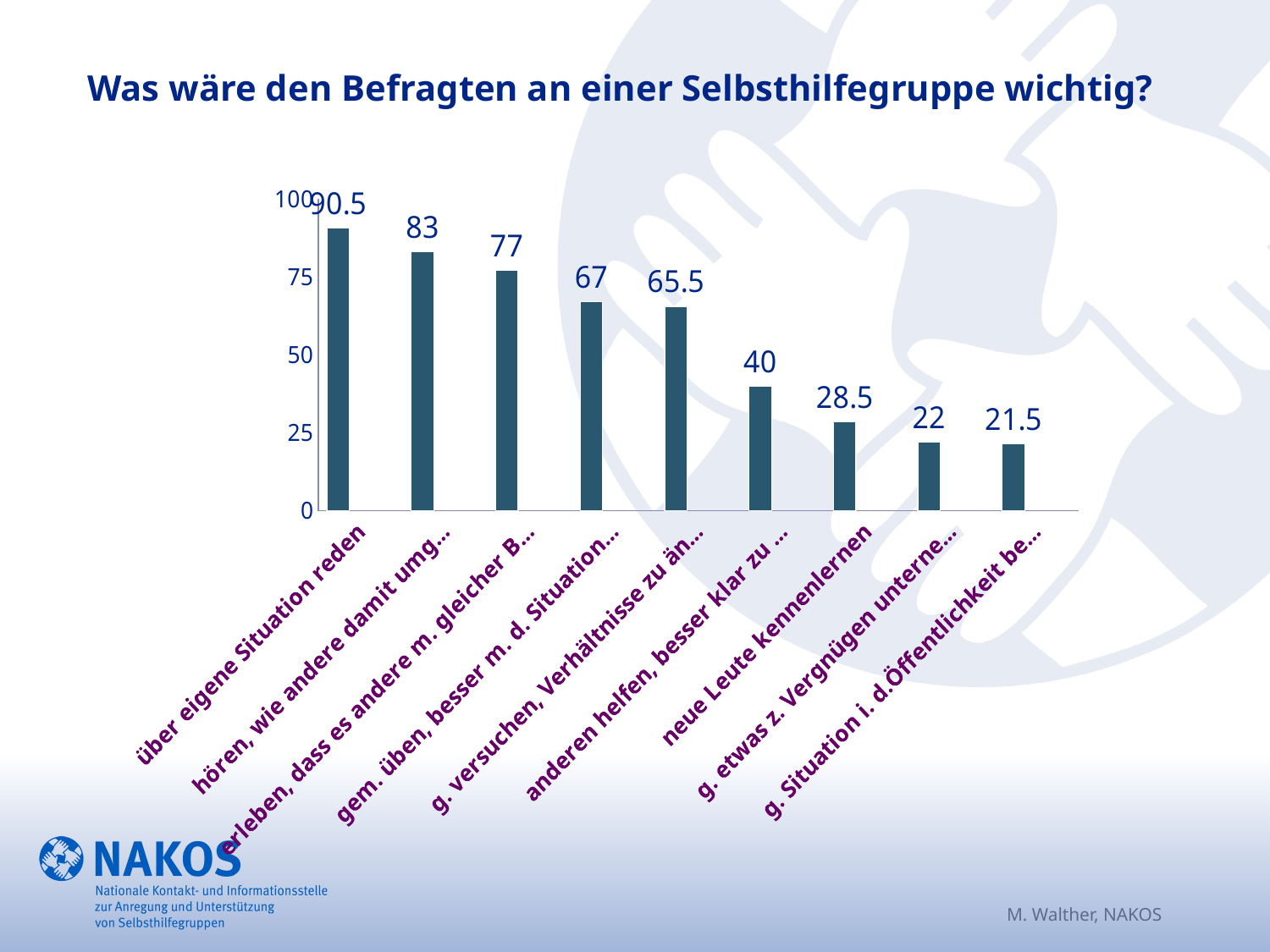
How many bars are shown in the chart? 9 What value is shown for "neue Leute kennenlernen"? 28.5 What is the difference between the value for "über eigene Situation reden" and the value for "neue Leute kennenlernen"? 62 Do the values rise or fall from left to right across the bars? fall What value is shown for "über eigene Situation reden"? 90.5 Is the value for "anderen helfen, besser klar zu ..." greater or less than 50? less What kind of chart is shown on the slide? bar chart What value is shown for the second bar from the left, "hören, wie andere damit umg..."? 83 Which category has the highest value? über eigene Situation reden Which is larger: the value for "neue Leute kennenlernen" or the value for "g. etwas z. Vergnügen unterne..."? neue Leute kennenlernen What value is shown for the rightmost bar, "g. Situation i. d. Öffentlichkeit be..."? 21.5 Which category has the lowest value? g. Situation i. d. Öffentlichkeit be...